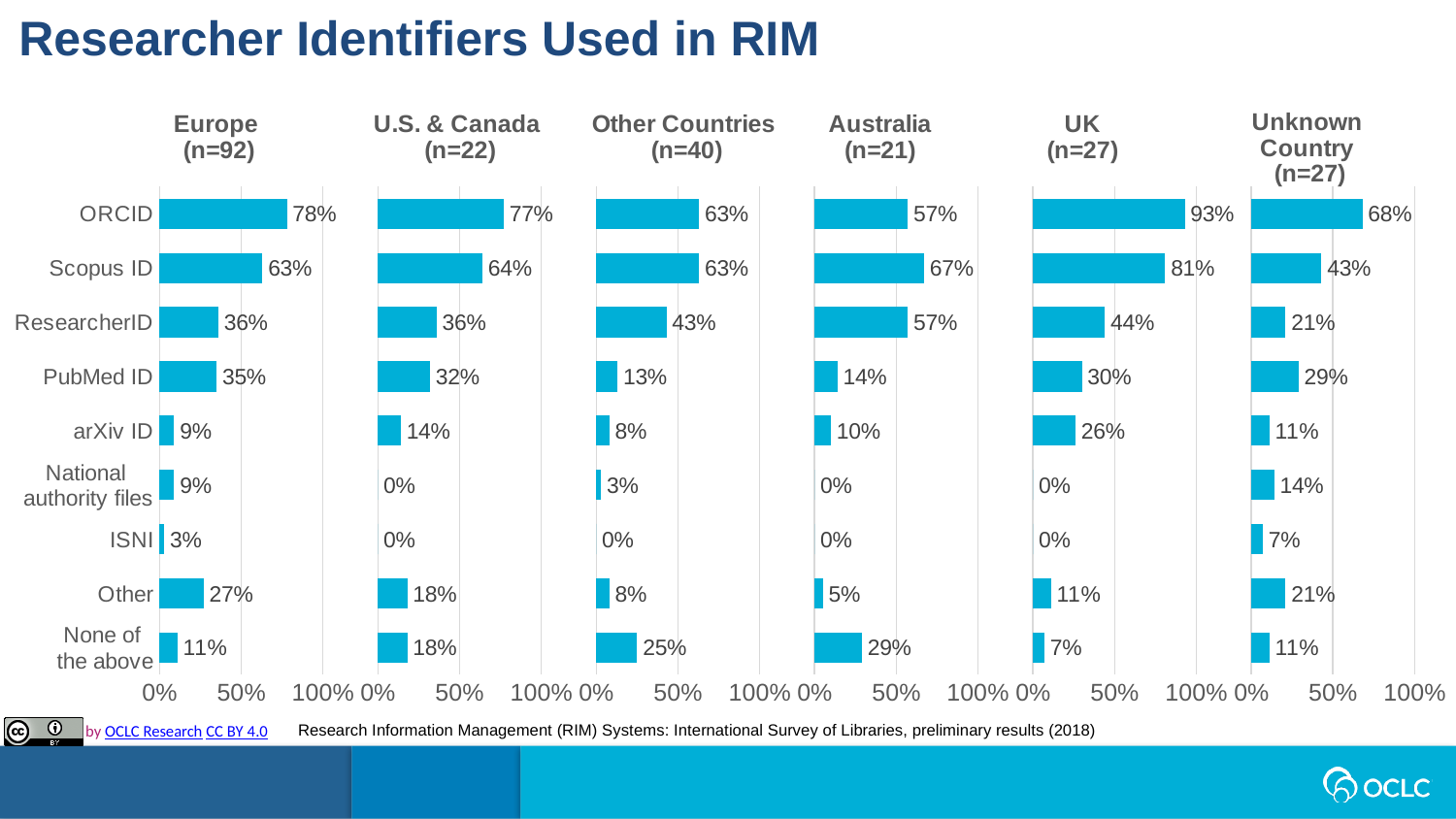
In the Unknown Country (n=27) chart, which identifier has the lowest value? ISNI In the Australia (n=21) chart, what is the value for None of the above? 29% How many categories are shown on the y axis of the Europe (n=92) chart? 9 In the UK (n=27) chart, which identifier has the highest value? ORCID In the Europe (n=92) chart, is the value for Scopus ID greater or less than 50%? greater In the Other Countries (n=40) chart, what is the difference between the ORCID value and the PubMed ID value? 50% In the Australia (n=21) chart, what is the difference between the Scopus ID value and the ORCID value? 10% In the UK (n=27) chart, what is the value for arXiv ID? 26% In the Europe (n=92) chart, what is the value for ORCID? 78% What is the title of the slide? Researcher Identifiers Used in RIM What kind of chart is used for the Australia (n=21) panel? bar chart In the U.S. & Canada (n=22) chart, which is larger, the value for Scopus ID or the value for ORCID? ORCID